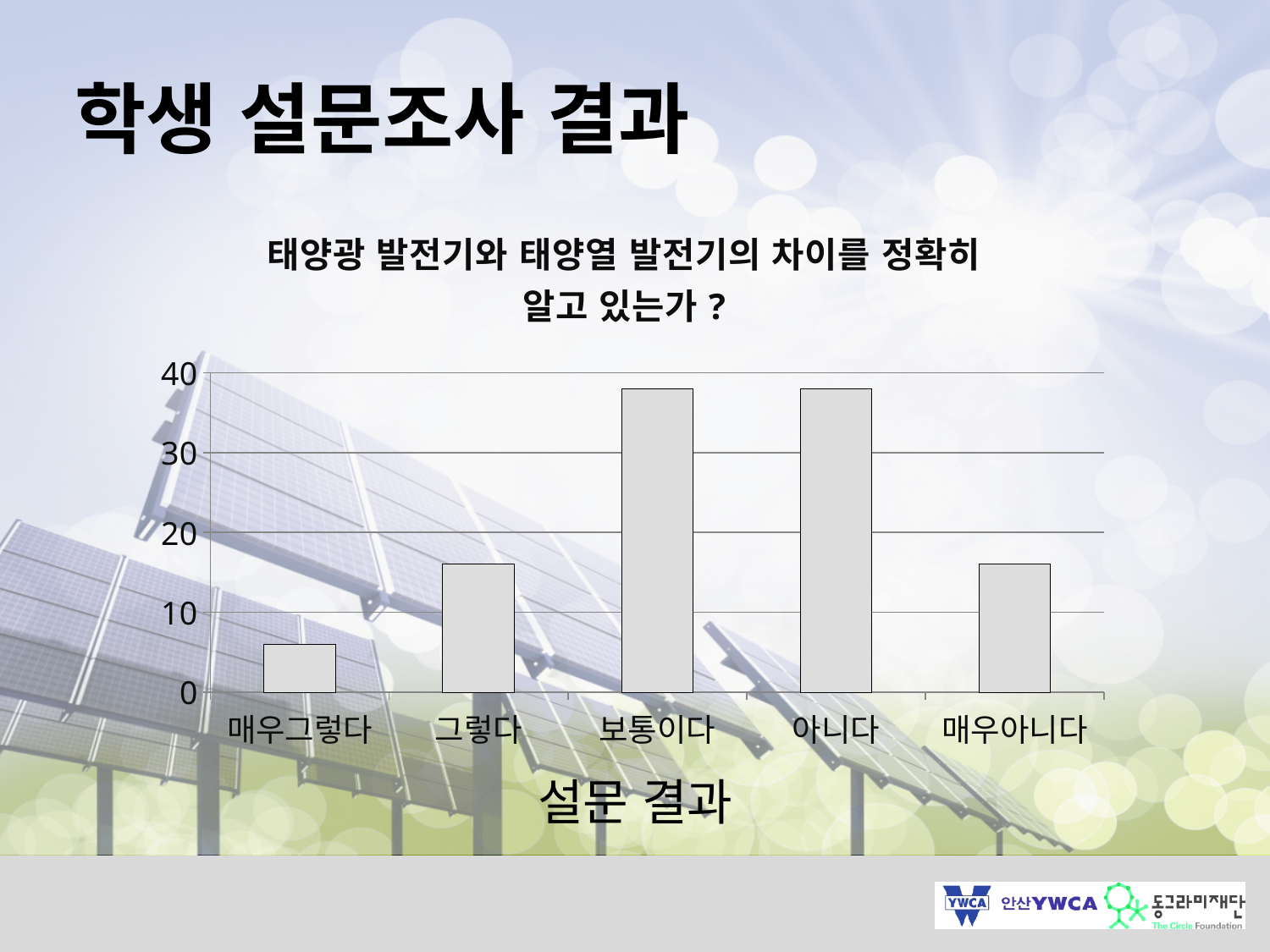
Is the value for 그렇다 greater or less than 10? greater Is the value for 매우아니다 greater or less than 20? less Is the value for 아니다 greater or less than 40? less What is the title of the chart? 태양광 발전기와 태양열 발전기의 차이를 정확히 알고 있는가 ? How many categories are shown on the x axis of the chart? 5 What kind of chart is shown on the slide? Bar chart Which is larger, the value for 보통이다 or the value for 매우그렇다? 보통이다 Which is larger, the value for 아니다 or the value for 매우아니다? 아니다 What is the label shown below the x axis of the chart? 설문 결과 Which category has the lowest value in the chart? 매우그렇다